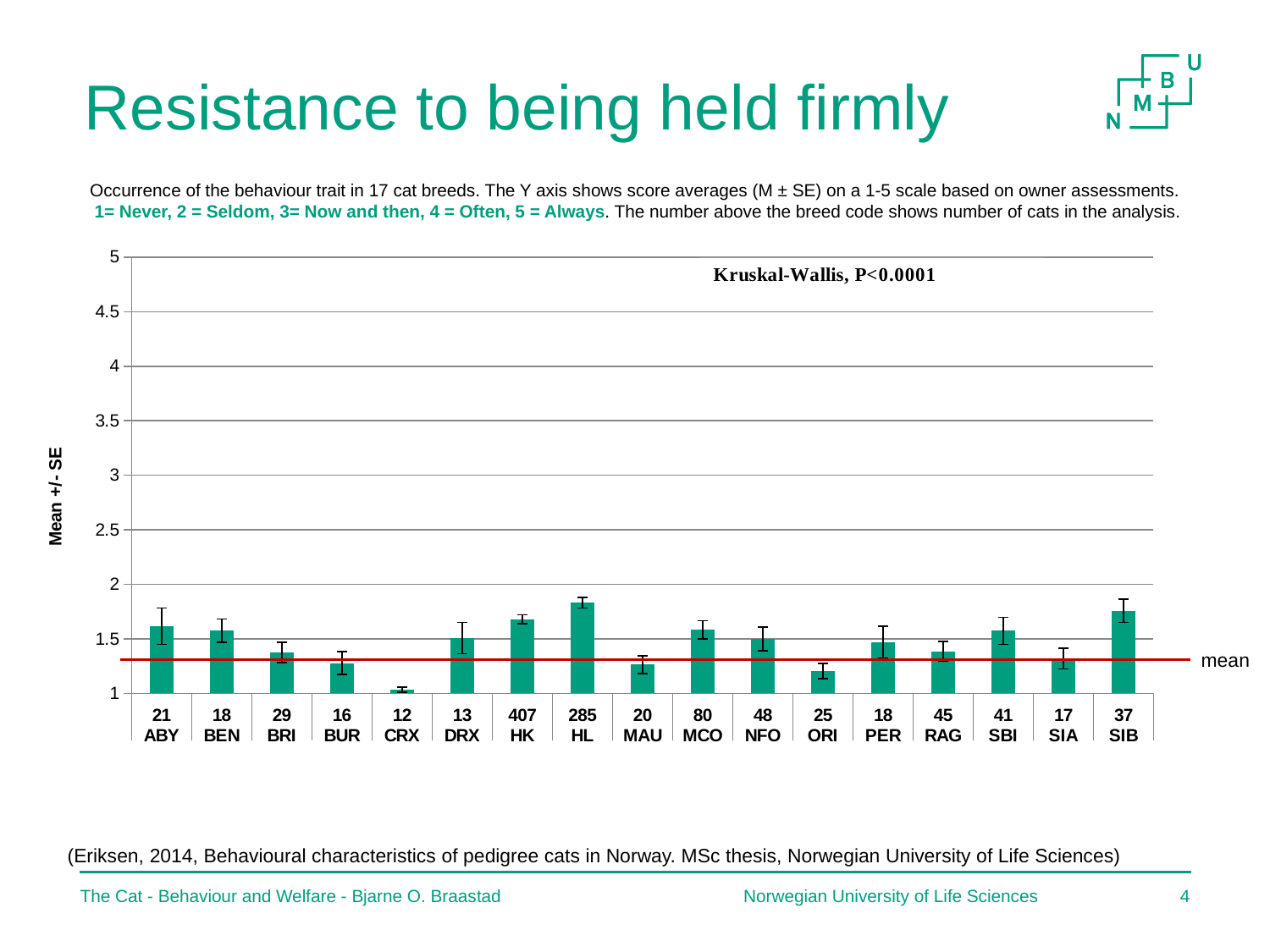
Is the value for HL greater or less than 1.5? greater Is the value for SIB greater or less than 1.5? greater Is the value for CRX greater or less than 1.5? less How many cats were included in the analysis for the HK breed? 407 What kind of chart is shown on the slide? bar chart Which breed has the larger mean score, HK or BUR? HK Which breed has the lowest mean score for resistance to being held firmly? CRX How many cats were included in the analysis for the HL breed? 285 What is the label of the y axis? Mean +/- SE How many cat breeds are plotted along the x axis? 17 Which breed has the highest mean score for resistance to being held firmly? HL